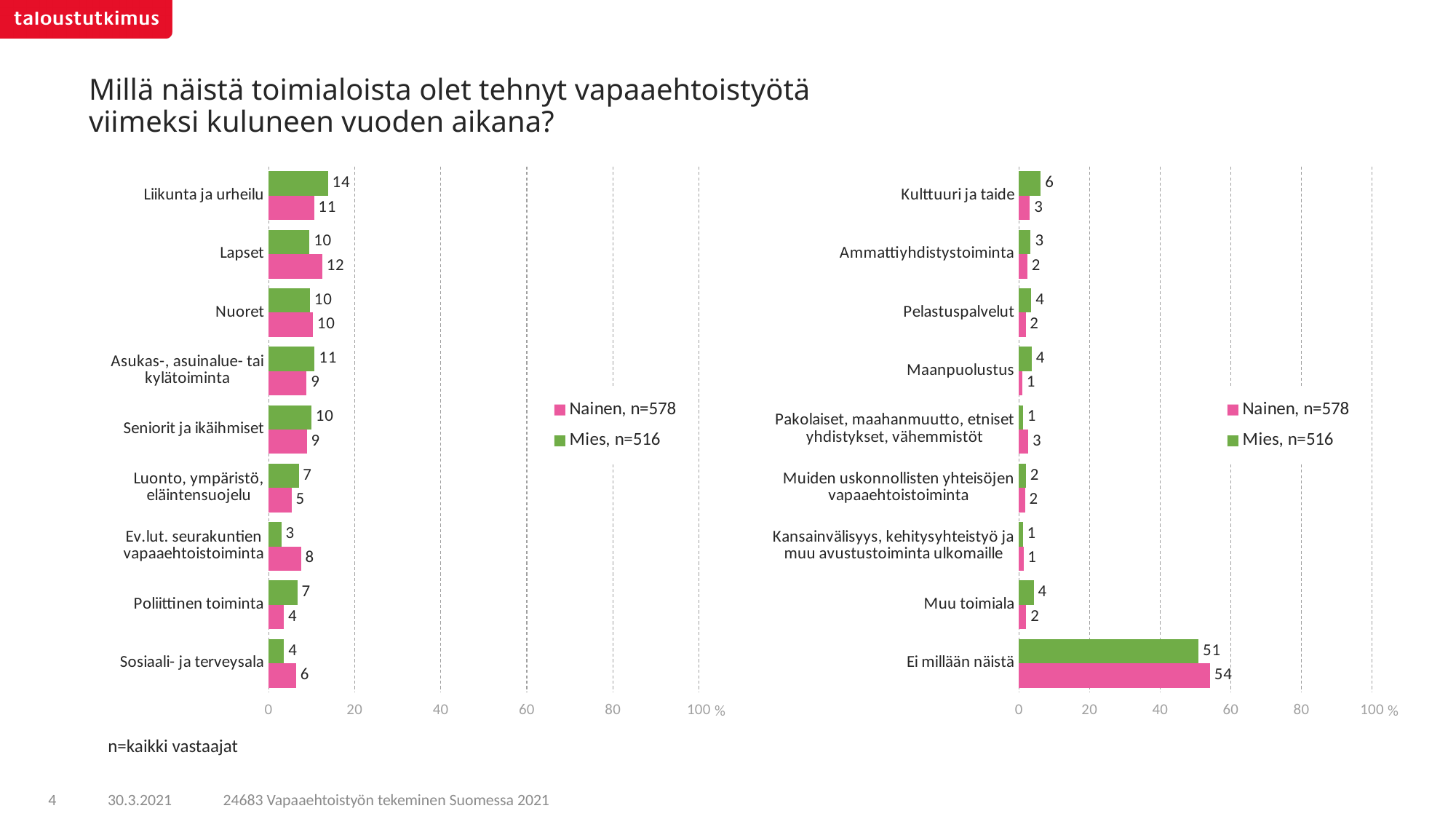
How many series does the legend of the right chart list? 2 What type of chart is the left chart? bar chart In the left chart, what is the value for Mies for Liikunta ja urheilu? 14 In the right chart, what is the value for Mies for Kulttuuri ja taide? 6 In the right chart, which is larger for Ei millään näistä, Nainen or Mies? Nainen How many categories are shown in the left chart? 9 In the right chart, is the value for Mies for Ei millään näistä greater or less than 40? greater In the left chart, what is the value for Nainen for Ev.lut. seurakuntien vapaaehtoistoiminta? 8 In the left chart, what is the difference between the Nainen and Mies values for Ev.lut. seurakuntien vapaaehtoistoiminta? 5 In the left chart, which category has the highest value for Mies? Liikunta ja urheilu In the right chart, what is the value for Nainen for Ei millään näistä? 54 In the right chart, which category has the lowest value for Nainen? Maanpuolustus and Kansainvälisyys, kehitysyhteistyö ja muu avustustoiminta ulkomaille (both 1)